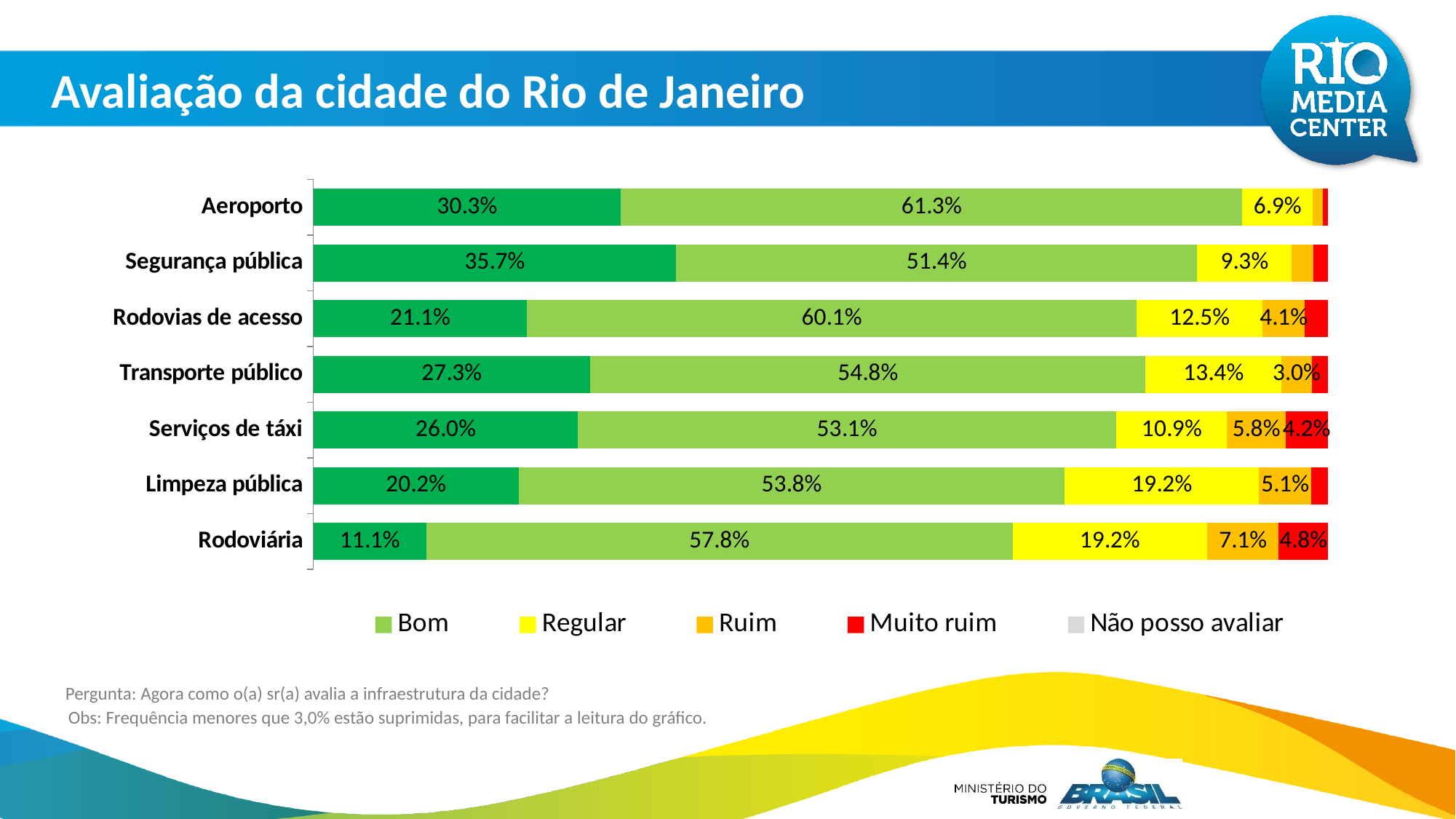
How many categories (rows) are plotted in the chart? 7 What is the 'Bom' value for Aeroporto? 61.3% Which category has the highest 'Bom' value? Aeroporto What is the difference between the 'Bom' value for Aeroporto and the 'Bom' value for Segurança pública? 9.9 percentage points Which category has the lowest 'Regular' value? Aeroporto How many series does the chart legend list? 5 What is the 'Ruim' value for Rodovias de acesso? 4.1% What is the 'Regular' value for Rodoviária? 19.2% Which has a larger 'Bom' value: Rodovias de acesso or Transporte público? Rodovias de acesso What is the title of the chart slide? Avaliação da cidade do Rio de Janeiro What is the 'Muito ruim' value for Rodoviária? 4.8% What type of chart is shown on the slide? Stacked bar chart